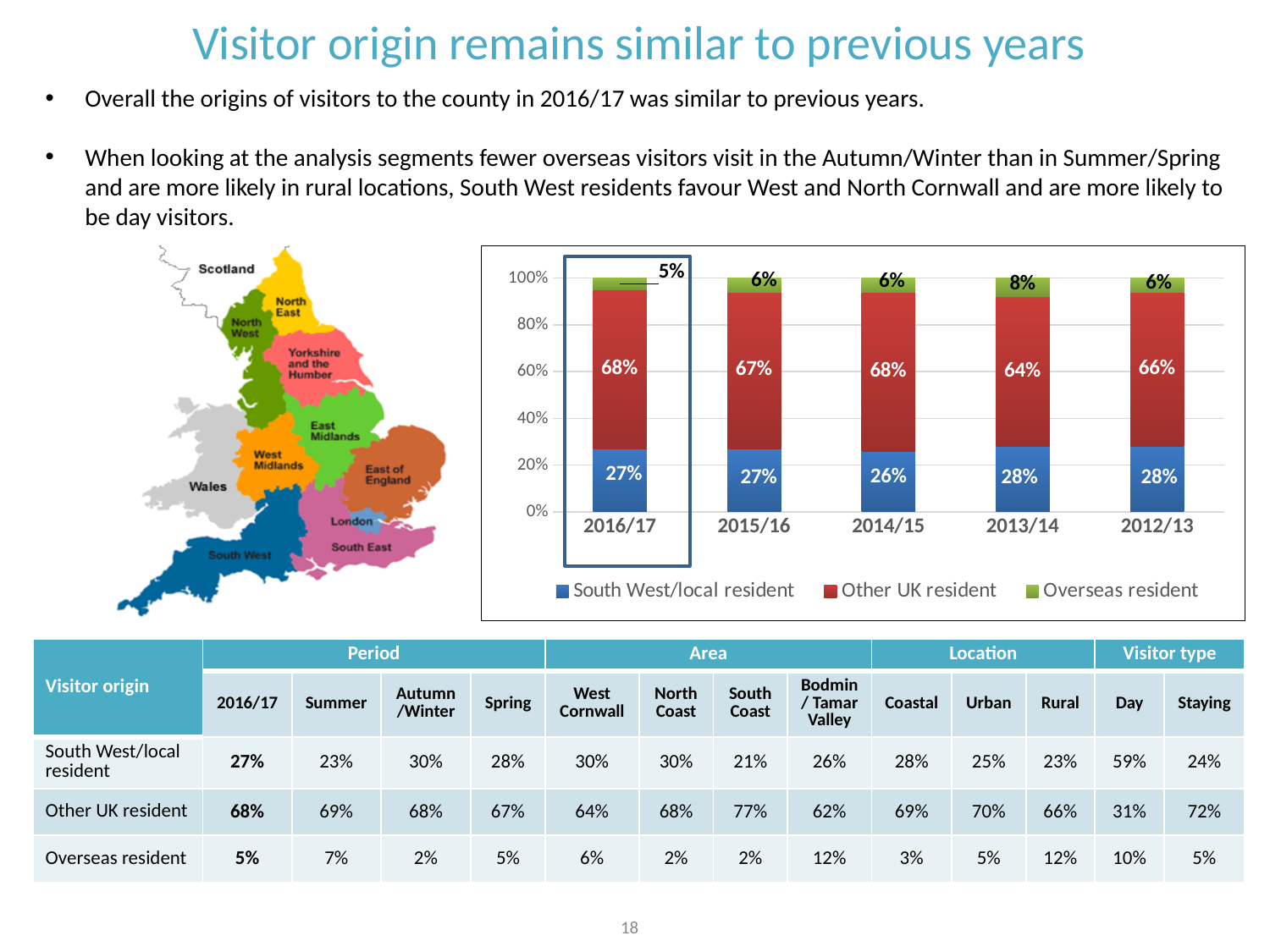
What is the value for South West/local resident in 2014/15? 26% What is the difference between the Other UK resident values for 2016/17 and 2013/14? 4% How many years are shown on the x axis? 5 Which is larger, the South West/local resident value for 2013/14 or for 2014/15? 2013/14 What is the value for Overseas resident in 2013/14? 8% How many series does the legend list? 3 Which year has the lowest value for Other UK resident? 2013/14 What is the value for Other UK resident in 2016/17? 68% What is the total of the stacked bar for 2012/13? 100% Which year has the highest value for Overseas resident? 2013/14 Which series is shown in green in the legend? Overseas resident What kind of chart is shown? Stacked bar chart